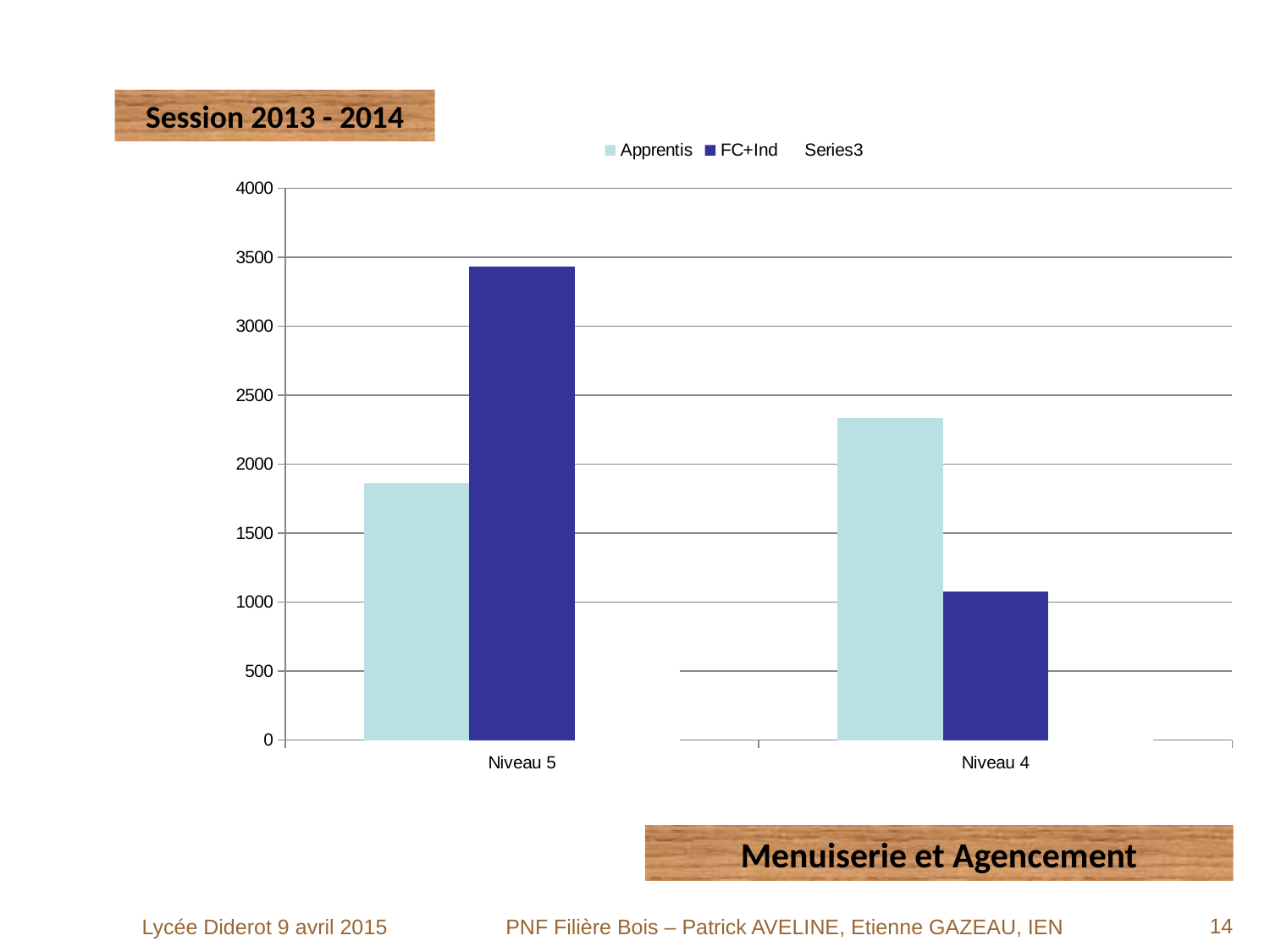
Does the FC+Ind series rise or fall from Niveau 5 to Niveau 4? fall What kind of chart is shown on the slide? bar chart Which bar is the tallest in the chart? FC+Ind at Niveau 5 How many categories are shown on the x axis? 2 Is the value for Apprentis at Niveau 5 greater or less than 2000? less How many series does the legend list? 3 At Niveau 4, which series has the larger value, Apprentis or FC+Ind? Apprentis Is the value for FC+Ind at Niveau 4 greater or less than 1500? less Is the value for FC+Ind at Niveau 5 greater or less than 3000? greater Which bar is the shortest in the chart? FC+Ind at Niveau 4 At Niveau 5, which series has the larger value, Apprentis or FC+Ind? FC+Ind